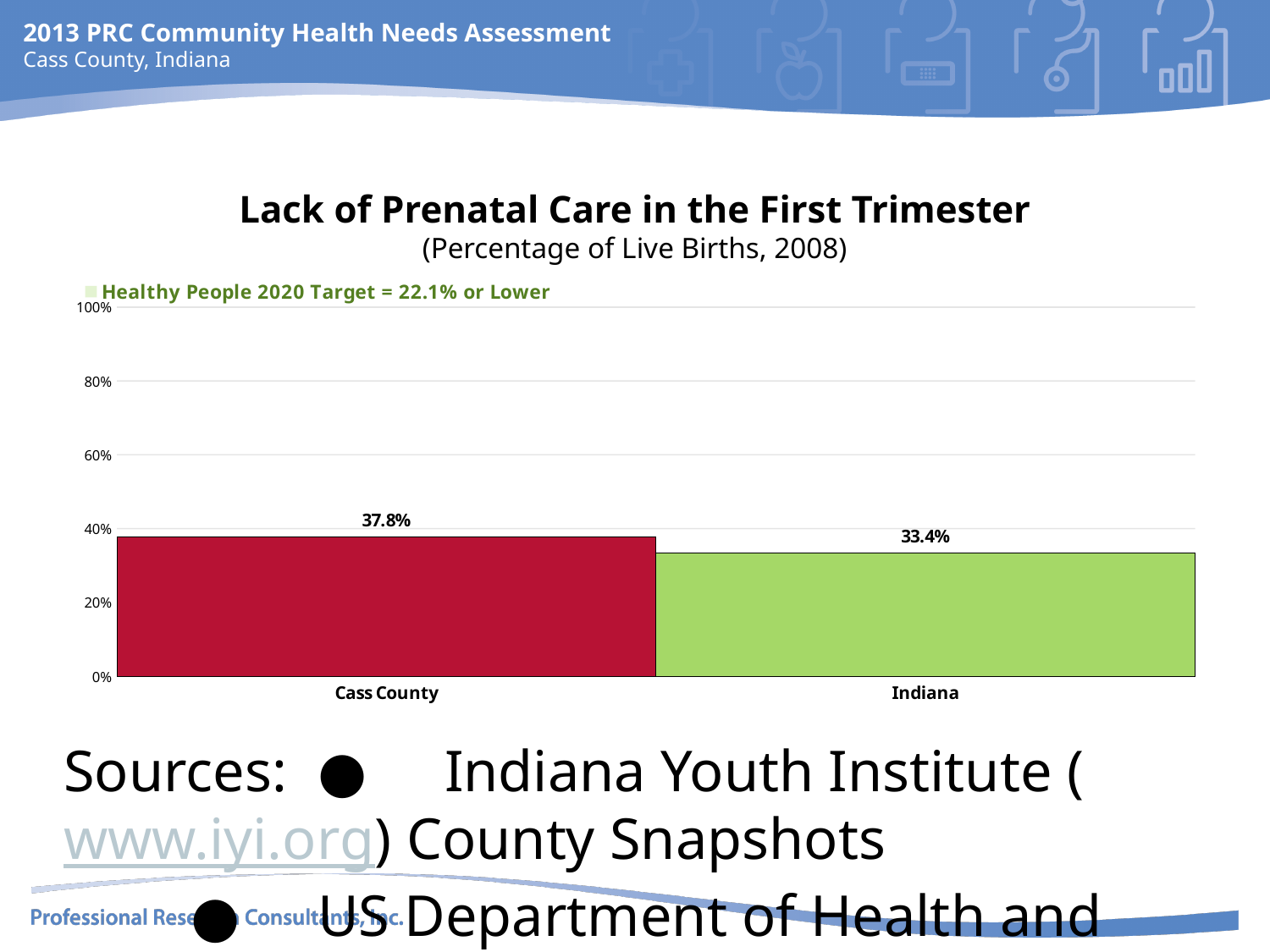
What kind of chart is shown on the slide? bar chart What is the difference between the values for Cass County and Indiana? 4.4% Which category has the lowest value? Indiana What Healthy People 2020 target is stated in the chart legend? 22.1% or Lower Is the value for Indiana greater or less than 20%? greater What is the value for Indiana? 33.4% Which is larger, the value for Cass County or the value for Indiana? Cass County What is the value for Cass County? 37.8% What is the title of the chart? Lack of Prenatal Care in the First Trimester Which category has the highest value? Cass County How many categories are shown in the chart? 2 Is the value for Cass County greater or less than 40%? less